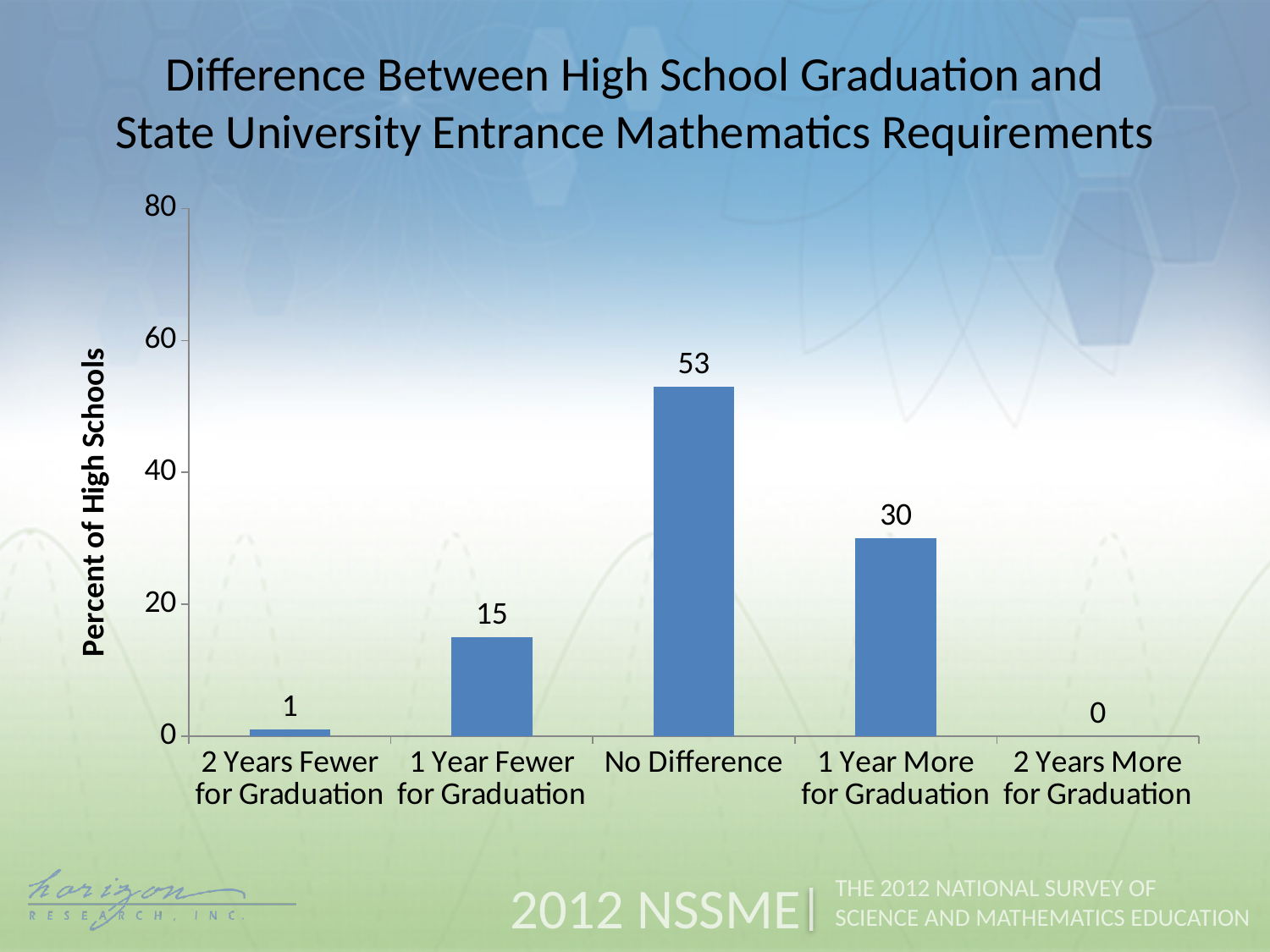
What is the label of the vertical axis? Percent of High Schools How many categories are shown on the x axis? 5 What is the value for '1 Year Fewer for Graduation'? 15 What is the value for '2 Years More for Graduation'? 0 What percent of high schools have no difference between graduation and state university entrance mathematics requirements? 53 What is the difference between the values for 'No Difference' and '1 Year More for Graduation'? 23 What kind of chart is shown on the slide? Bar chart Which category has the highest percent of high schools? No Difference What is the value for '1 Year More for Graduation'? 30 Which category has the lowest percent of high schools? 2 Years More for Graduation Which is larger, the value for '1 Year Fewer for Graduation' or '1 Year More for Graduation'? 1 Year More for Graduation What is the value for '2 Years Fewer for Graduation'? 1